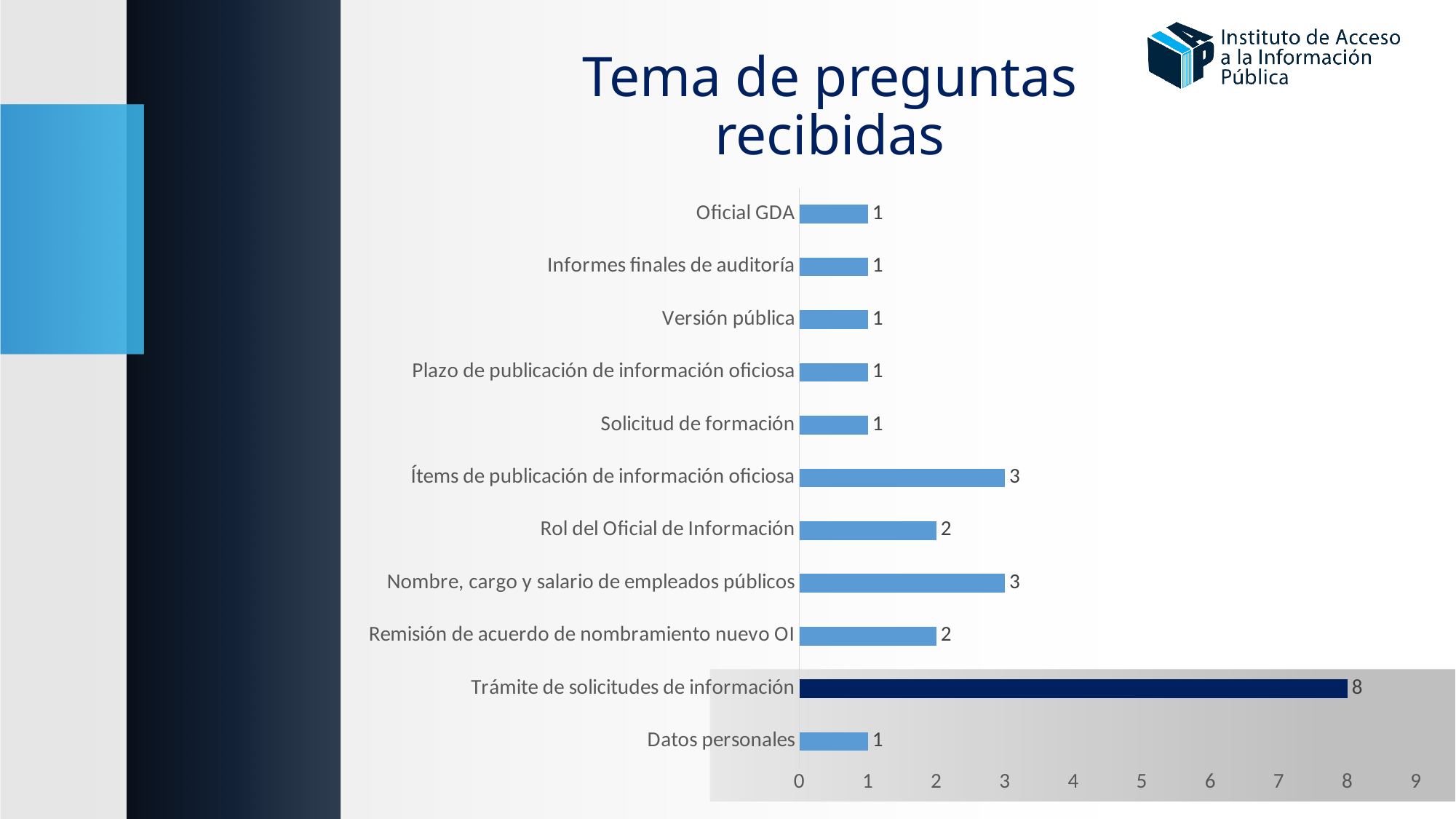
What is the value for Trámite de solicitudes de información? 8 How many categories are shown in the chart? 11 What is the value for Ítems de publicación de información oficiosa? 3 What is the value for Datos personales? 1 What is the difference between Trámite de solicitudes de información and Nombre, cargo y salario de empleados públicos? 5 Which category has the highest value? Trámite de solicitudes de información What is the title of the chart? Tema de preguntas recibidas What is the value for Rol del Oficial de Información? 2 Which bar is shown in a darker colour than the others? Trámite de solicitudes de información What kind of chart is shown on the slide? bar chart Is the value for Trámite de solicitudes de información greater or less than 5? greater Which is larger, Remisión de acuerdo de nombramiento nuevo OI or Ítems de publicación de información oficiosa? Ítems de publicación de información oficiosa